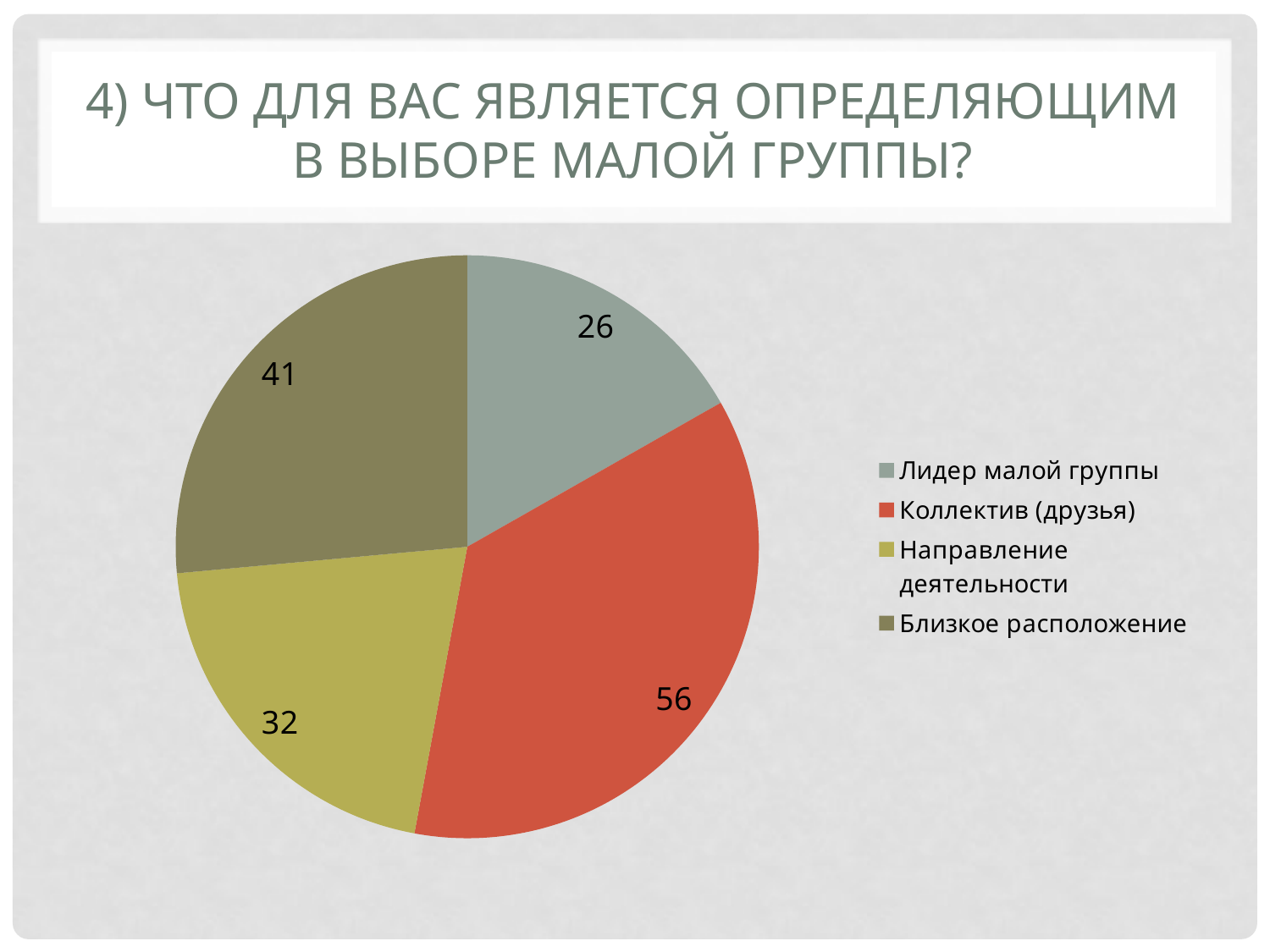
What kind of chart is shown on the slide? Pie chart What value is shown for the Направление деятельности slice? 32 What value is shown for the Коллектив (друзья) slice? 56 What is the difference between the values for Направление деятельности and Лидер малой группы? 6 How many categories does the pie chart show? 4 What is the total of all the values shown in the pie chart? 155 Which is larger, the value for Близкое расположение or the value for Направление деятельности? Близкое расположение What value is shown for the Лидер малой группы slice? 26 What is the difference between the values for Коллектив (друзья) and Близкое расположение? 15 What value is shown for the Близкое расположение slice? 41 Which category has the smallest slice of the pie? Лидер малой группы Which category has the largest slice of the pie? Коллектив (друзья)